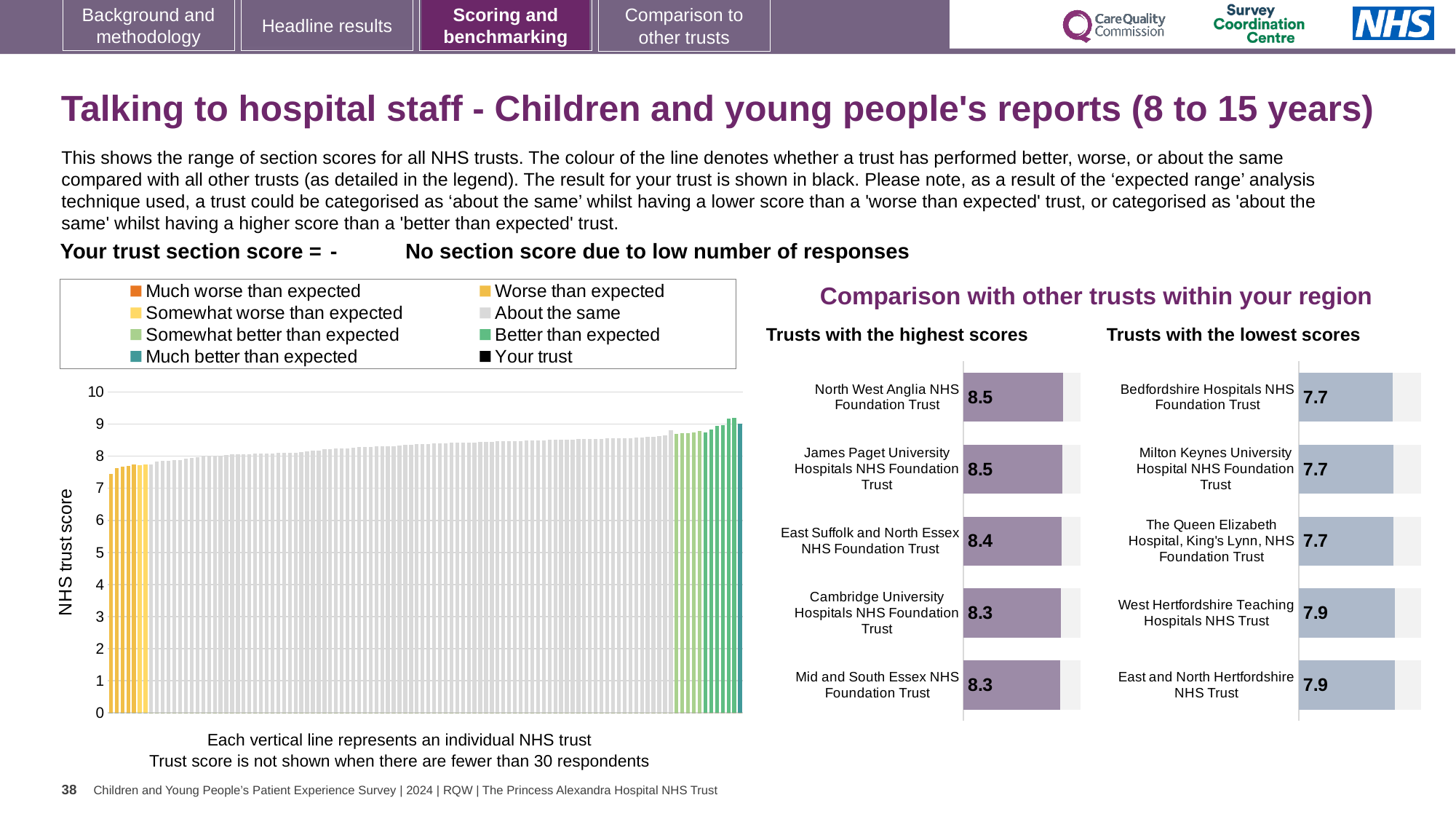
What kind of chart is the large chart on the left showing NHS trust scores? Bar chart How many entries does the legend above the large chart on the left list? 8 In the 'Trusts with the highest scores' chart, what is the highest score shown? 8.5 In the 'Trusts with the highest scores' chart, what is the difference between the scores of North West Anglia NHS Foundation Trust and Mid and South Essex NHS Foundation Trust? 0.2 In the 'Trusts with the lowest scores' chart, what is the score for West Hertfordshire Teaching Hospitals NHS Trust? 7.9 In the 'Trusts with the lowest scores' chart, what is the lowest score shown? 7.7 In the 'Trusts with the lowest scores' chart, what is the score for Bedfordshire Hospitals NHS Foundation Trust? 7.7 In the large chart on the left showing all NHS trusts, is the value of the tallest bar greater or less than 8? greater In the 'Trusts with the highest scores' chart, what is the score for East Suffolk and North Essex NHS Foundation Trust? 8.4 In the 'Trusts with the highest scores' chart, which has the larger score: East Suffolk and North Essex NHS Foundation Trust or Mid and South Essex NHS Foundation Trust? East Suffolk and North Essex NHS Foundation Trust In the 'Trusts with the highest scores' chart, what is the score for Cambridge University Hospitals NHS Foundation Trust? 8.3 In the 'Trusts with the lowest scores' chart, how many trusts are listed? 5